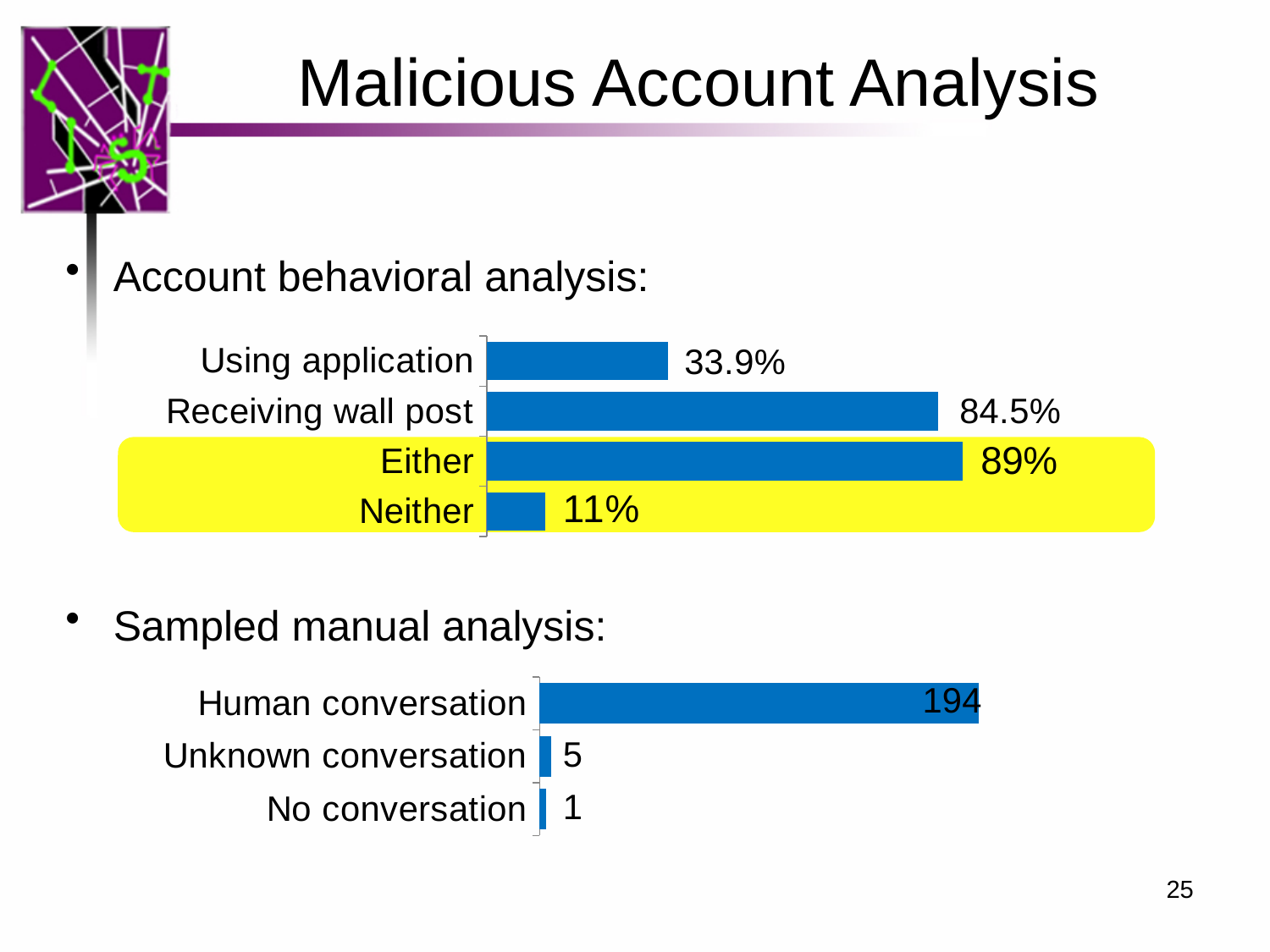
How many categories does the Account behavioral analysis chart show? 4 In the Sampled manual analysis chart, which category has the lowest value? No conversation In the Account behavioral analysis chart, which category has the lowest value? Neither In the Account behavioral analysis chart, what is the difference between Either and Neither? 78% In the Sampled manual analysis chart, what is the value for Human conversation? 194 In the Account behavioral analysis chart, what is the value for Receiving wall post? 84.5% In the Account behavioral analysis chart, what is the value for Using application? 33.9% In the Account behavioral analysis chart, which category has the highest value? Either In the Account behavioral analysis chart, which is larger, Using application or Receiving wall post? Receiving wall post In the Sampled manual analysis chart, what is the value for Unknown conversation? 5 What kind of chart is the Sampled manual analysis chart? Bar chart In the Sampled manual analysis chart, what is the difference between Human conversation and Unknown conversation? 189